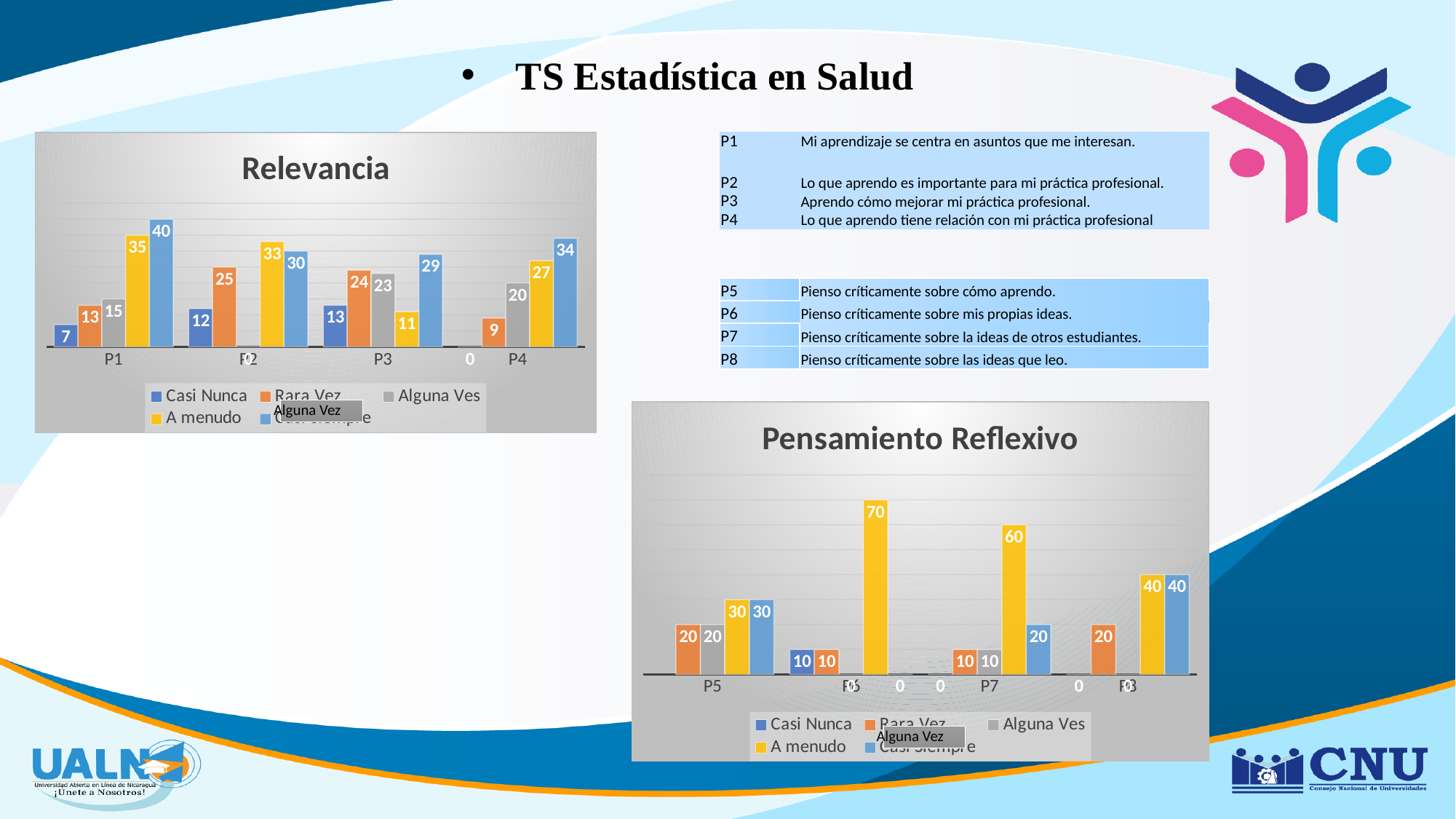
In the Relevancia chart, what is the difference between the Casi Siempre and Casi Nunca values for P1? 33 In the Relevancia chart, what is the value of A menudo for P3? 11 In the Relevancia chart, which is larger for P3: Rara Vez or A menudo? Rara Vez In the Relevancia chart, what is the value of Rara Vez for P2? 25 In the Relevancia chart, which category has the highest Casi Siempre value? P1 In the Pensamiento Reflexivo chart, what is the value of Casi Siempre for P7? 20 How many series does the legend of the Pensamiento Reflexivo chart list? 5 In the Pensamiento Reflexivo chart, what is the difference between the A menudo values for P6 and P7? 10 In the Relevancia chart, what is the value of Casi Siempre for P1? 40 In the Pensamiento Reflexivo chart, which category has the highest A menudo value? P6 In the Pensamiento Reflexivo chart, what is the value of A menudo for P6? 70 What kind of chart is the Relevancia chart? Bar chart